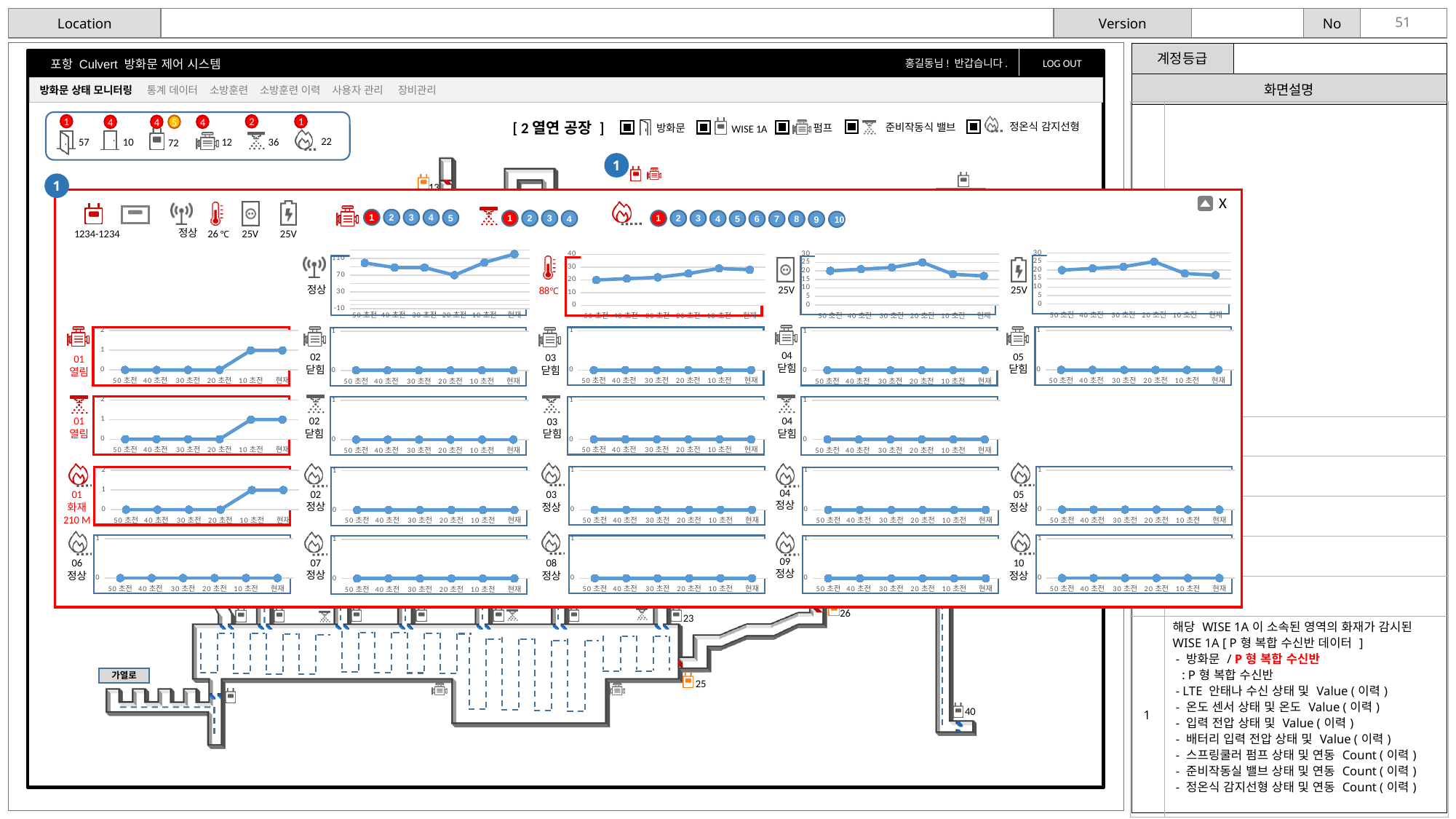
In the temperature chart (top row, labelled 88℃), is the value at 현재 greater or less than 20? greater What kind of chart is used for the '01 열림' pump chart at the left of the popup? line chart What is the first x-axis label on the '01 열림' pump chart? 50 초전 In the '02 닫힘' pump chart, what is the value at 현재? 0 In the LTE antenna chart (top row, labelled 정상), is the value at 현재 greater or less than 70? greater In the '01 열림' pump chart, do the values rise or fall from 50 초전 to 현재? rise In the '01 열림' pump chart (top-left of the chart grid), what is the value at 현재? 1 In the '01 열림' pump chart, what is the difference between the value at 현재 and the value at 50 초전? 1 How many time points are plotted along the x axis of the '01 열림' pump chart? 6 In the '02 닫힘' pump chart, do the values rise, fall, or stay flat across the x axis? stay flat In the '01 열림' pump chart, which is larger: the value at 현재 or the value at 50 초전? 현재 In the '01 열림' pump chart (top-left of the chart grid), what is the value at 50 초전? 0